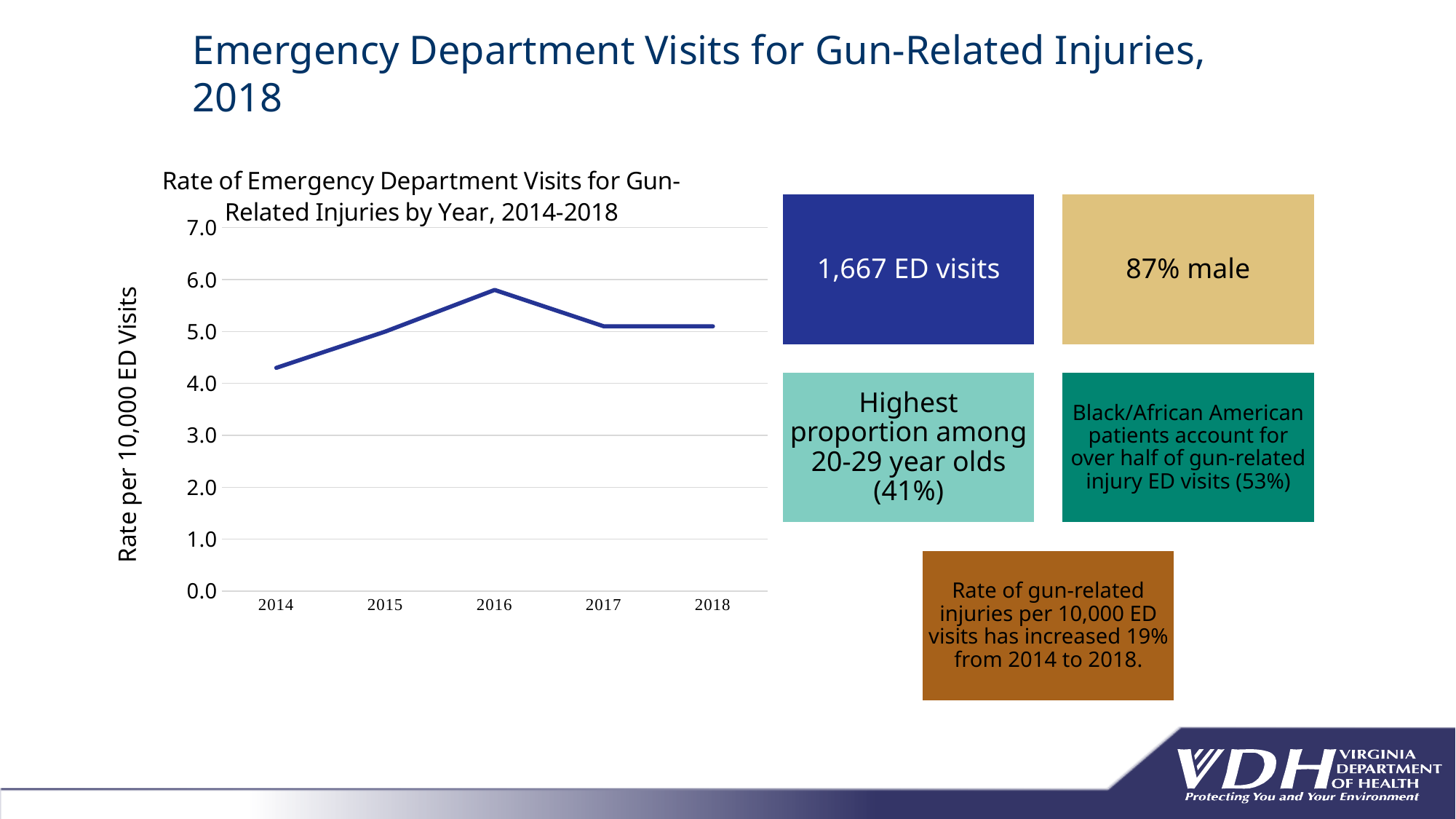
Does the rate rise or fall from 2014 to 2016? Rise How many years are plotted on the chart? 5 Is the rate for 2016 greater or less than 5.0? greater Is the rate for 2016 greater or less than 6.0? less Is the rate for 2014 greater or less than 5.0? less Which year has a higher rate, 2014 or 2016? 2016 What kind of chart is shown on the slide? Line chart Does the rate rise or fall from 2016 to 2017? Fall What is the label on the vertical axis of the chart? Rate per 10,000 ED Visits Which year has the highest rate of emergency department visits for gun-related injuries? 2016 Which year has the lowest rate of emergency department visits for gun-related injuries? 2014